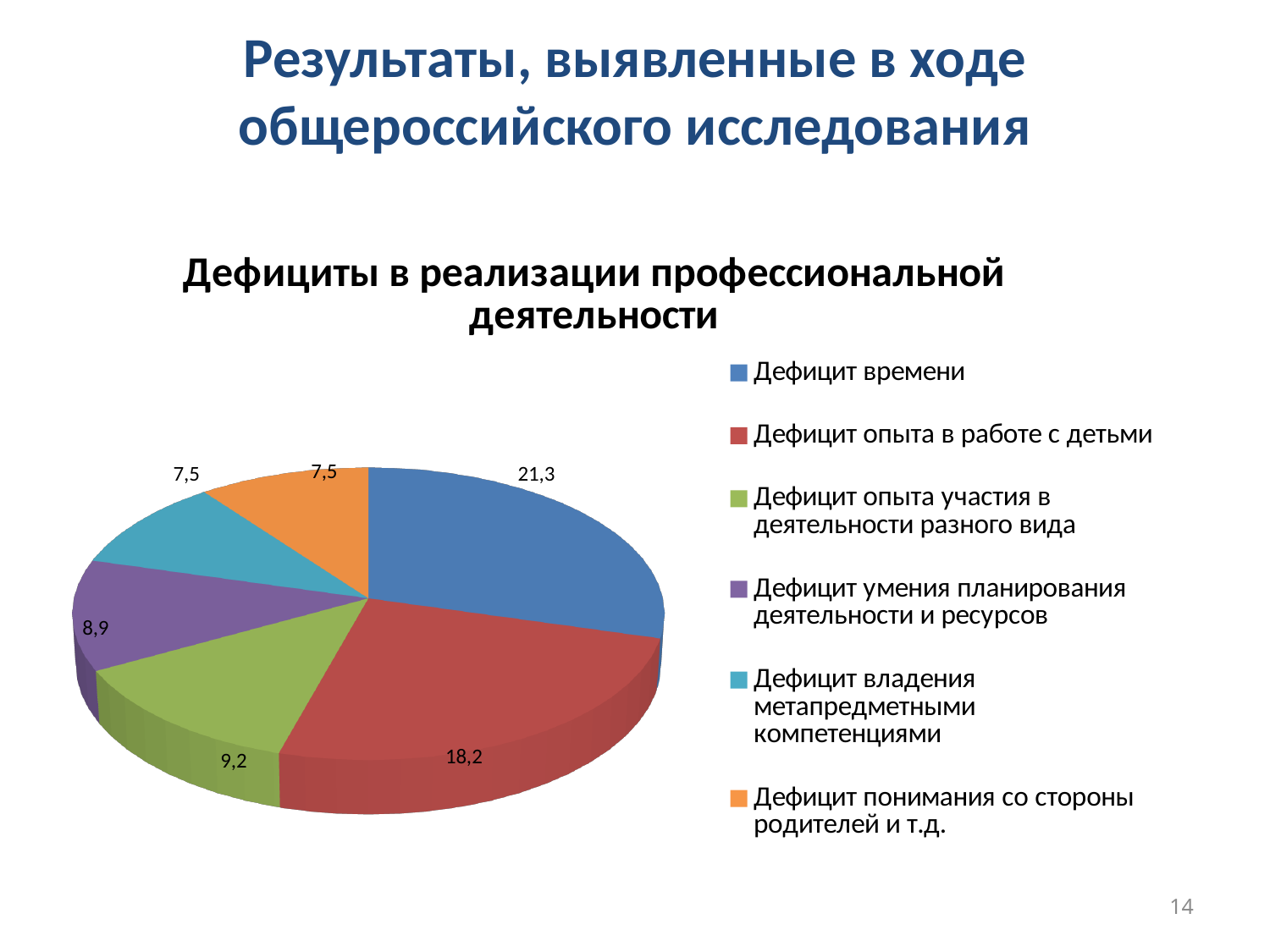
What is the value for "Дефицит владения метапредметными компетенциями"? 7,5 Which is larger: the value for "Дефицит опыта участия в деятельности разного вида" or for "Дефицит понимания со стороны родителей и т.д."? Дефицит опыта участия в деятельности разного вида What is the value for "Дефицит умения планирования деятельности и ресурсов"? 8,9 What is the value for "Дефицит опыта в работе с детьми"? 18,2 What is the value for "Дефицит времени"? 21,3 What is the title of the chart? Дефициты в реализации профессиональной деятельности Which colour represents "Дефицит понимания со стороны родителей и т.д." in the legend? Orange What is the value for "Дефицит опыта участия в деятельности разного вида"? 9,2 What type of chart is shown on the slide? Pie chart How many slices does the pie chart have? 6 What is the difference between the values for "Дефицит времени" and "Дефицит опыта в работе с детьми"? 3,1 Which category has the largest slice of the pie? Дефицит времени